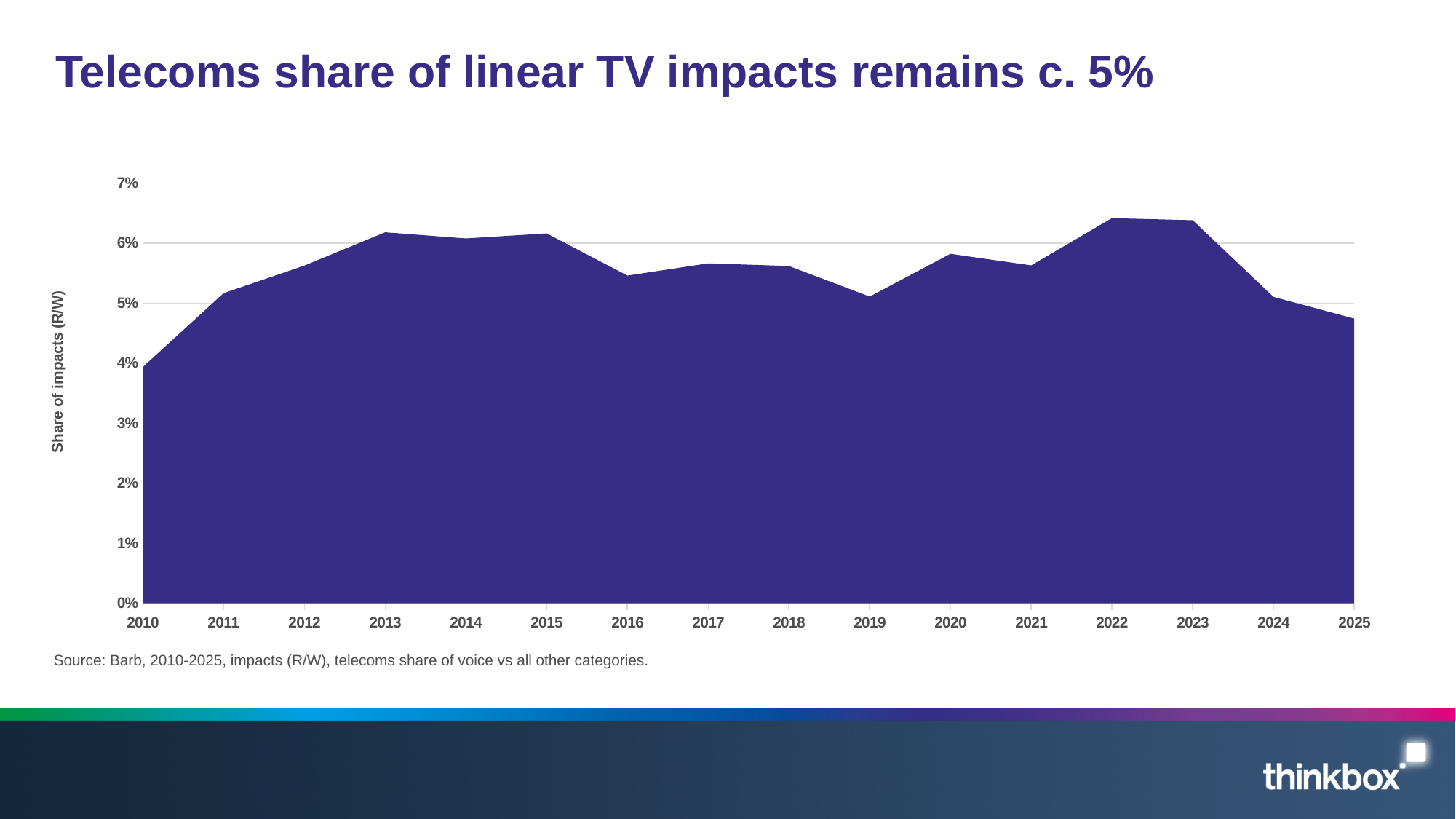
Is the value for 2022 greater or less than 6%? greater Is the value for 2025 greater or less than 5%? less Which year has the lowest telecoms share of impacts? 2010 Is the value for 2010 greater or less than 5%? less How many years are plotted along the x axis? 16 Which is larger, the value for 2013 or the value for 2016? 2013 Does the share of impacts rise or fall from 2023 to 2025? Fall What kind of chart is shown on the slide? Area chart What is the label on the y axis of the chart? Share of impacts (R/W) Which is larger, the value for 2019 or the value for 2020? 2020 Does the share of impacts rise or fall from 2010 to 2013? Rise